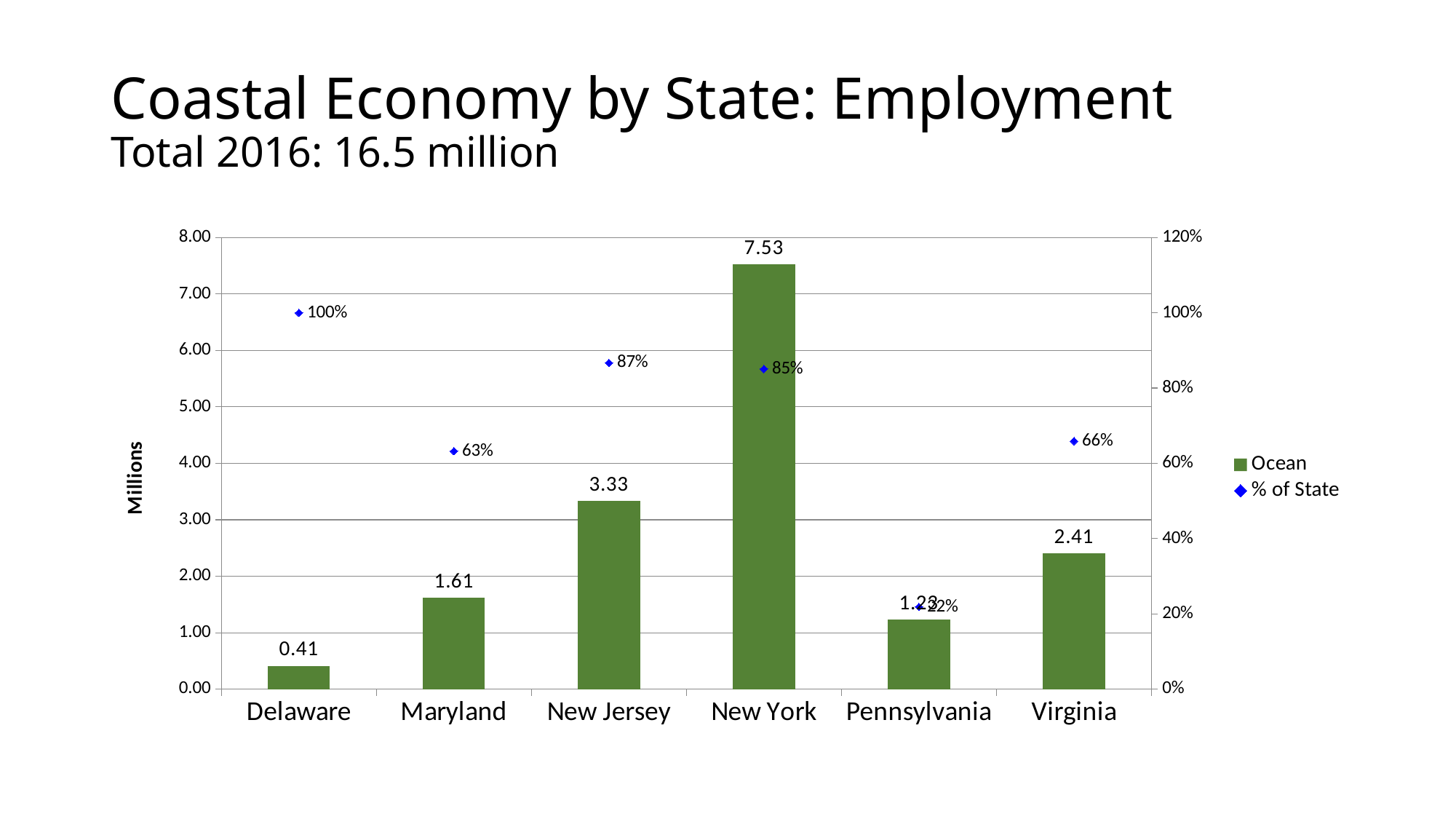
How many series does the legend list? 2 How many states are shown on the x axis? 6 What is the difference in Ocean employment between New York and New Jersey? 4.20 What is the % of State value for Virginia? 66% Is the Ocean employment value for Pennsylvania greater or less than 2.00? less What is the label of the left vertical axis? Millions What is the % of State value for Delaware? 100% Which has a higher % of State value, Maryland or New Jersey? New Jersey Which state has the lowest Ocean employment? Delaware What is the Ocean employment value for New York? 7.53 What is the Ocean employment value for New Jersey? 3.33 Which state has the highest Ocean employment? New York